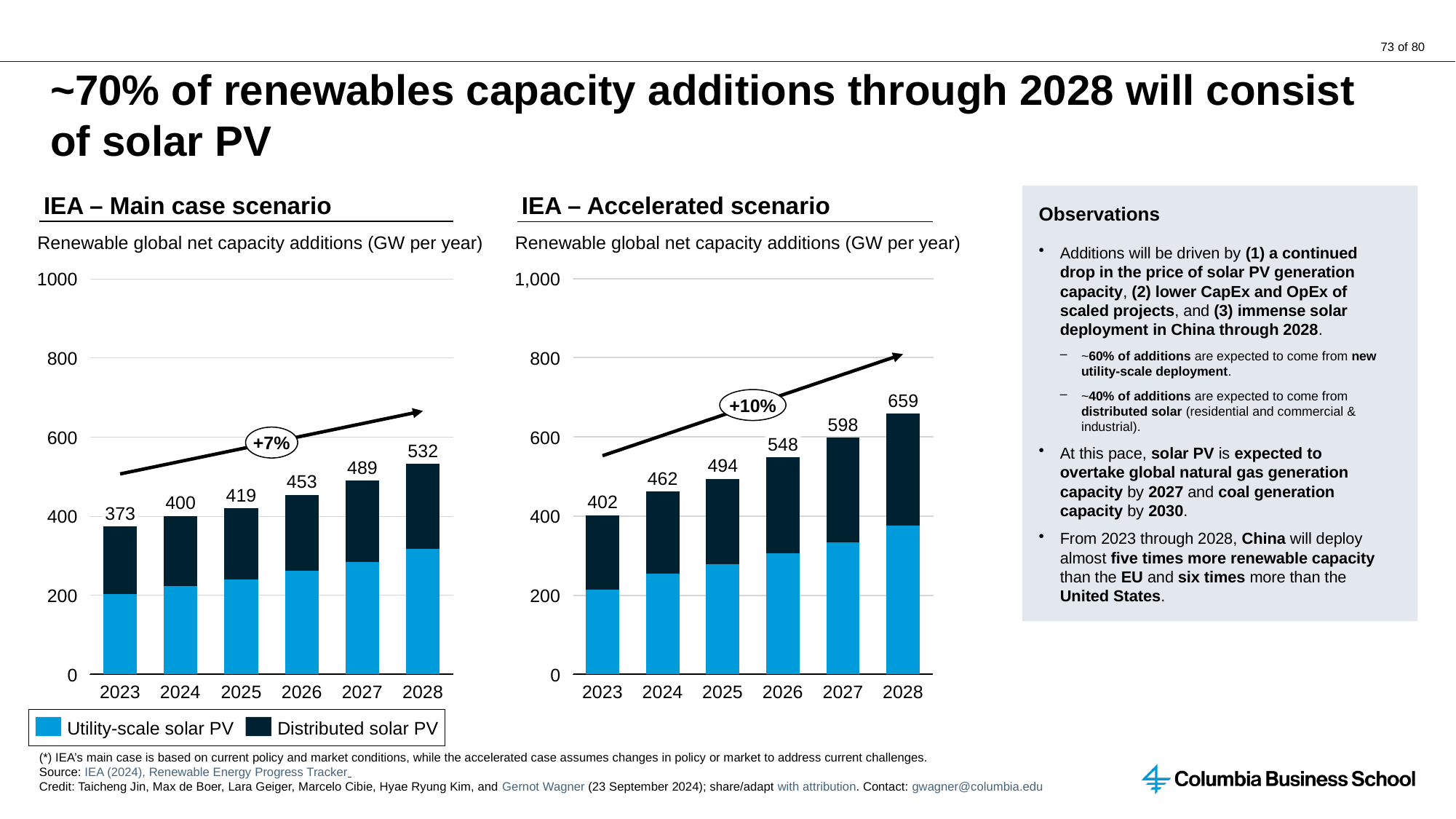
In the IEA – Main case scenario chart, which year has the lowest total capacity addition? 2023 What kind of chart is the IEA – Accelerated scenario chart? Stacked bar chart In the IEA – Accelerated scenario chart, is the Utility-scale solar PV value for 2028 greater or less than 400? less In the IEA – Main case scenario chart, what is the total renewable net capacity addition labelled for 2028? 532 In the IEA – Accelerated scenario chart, which year has the highest total capacity addition? 2028 In the IEA – Main case scenario chart, is the Utility-scale solar PV value for 2028 greater or less than 200? greater How many series does the legend list for the charts? 2 Comparing the two charts, which scenario shows a larger total for 2026: Main case or Accelerated? Accelerated How many years are shown on the x axis of the IEA – Main case scenario chart? 6 In the IEA – Accelerated scenario chart, do the total capacity additions rise or fall from 2023 to 2028? Rise In the IEA – Accelerated scenario chart, what is the total renewable net capacity addition labelled for 2023? 402 In the IEA – Main case scenario chart, what is the difference between the 2028 total and the 2023 total? 159